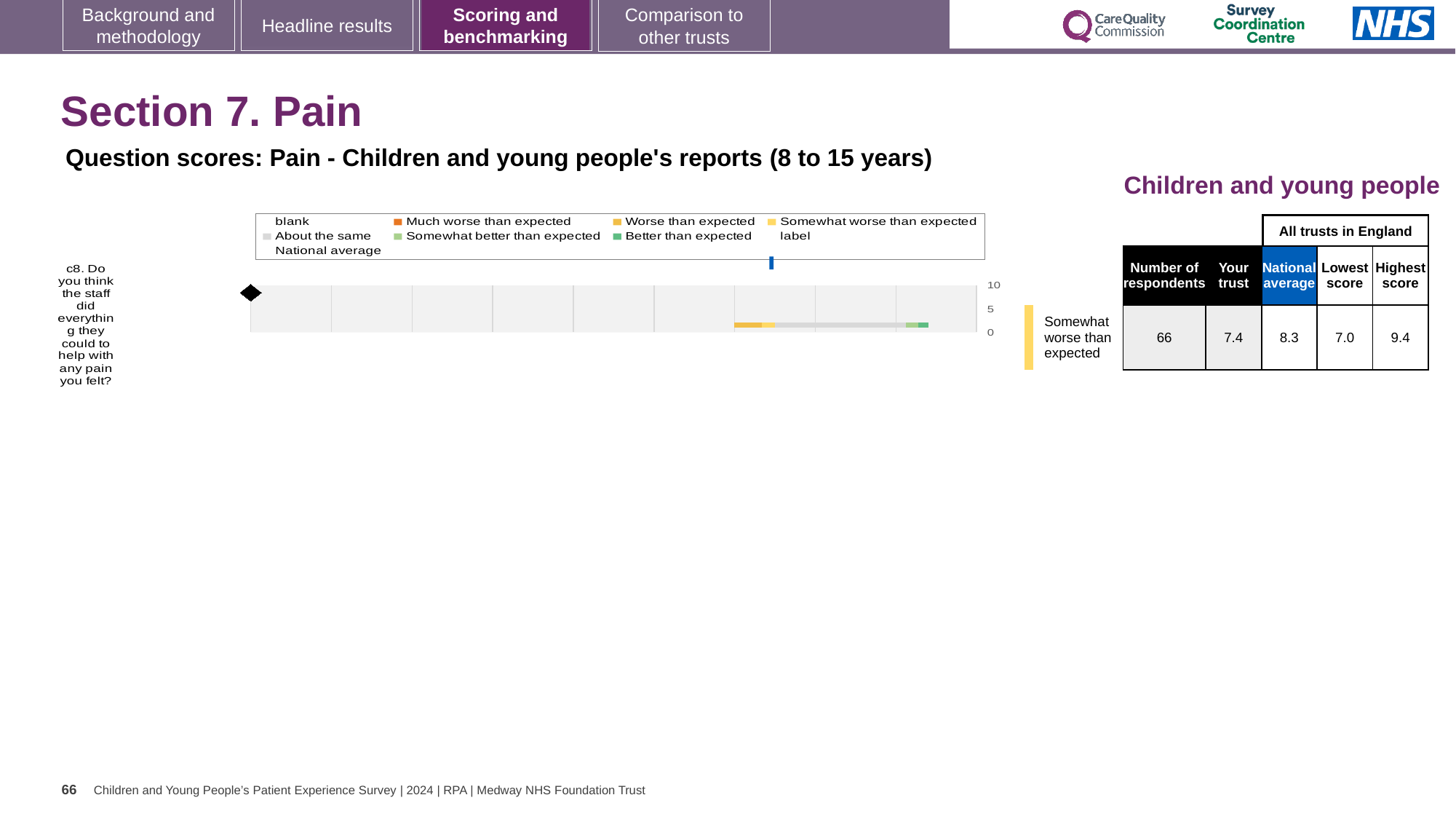
What is the highest tick value shown on the chart's axis? 10 Which question is plotted on the chart? c8. Do you think the staff did everything they could to help with any pain you felt? What benchmarking category is the trust's result for question c8 assigned to? Somewhat worse than expected What kind of chart is shown on the slide? bar chart How many question categories are plotted on the chart? 1 According to the table, what is the highest score among all trusts in England for question c8? 9.4 According to the table, what is the national average score for question c8? 8.3 How many respondents are listed in the table for question c8? 66 Which is larger for question c8: the 'Your trust' score or the national average? national average According to the table, what is the 'Your trust' score for question c8? 7.4 According to the table, what is the lowest score among all trusts in England for question c8? 7.0 What is the difference between the national average (8.3) and the 'Your trust' score (7.4) for question c8? 0.9